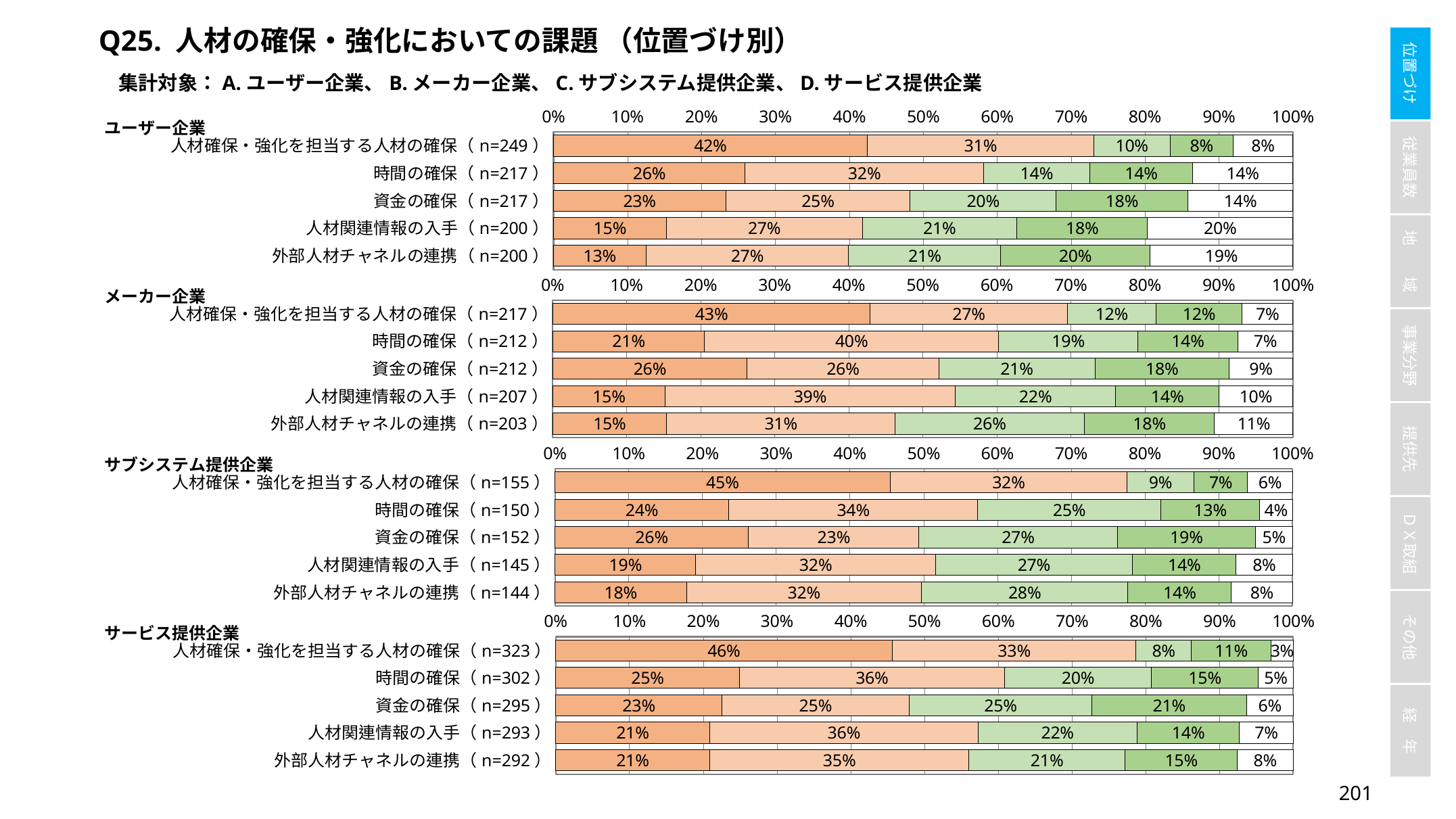
How many categories (bars) are shown in the ユーザー企業 chart? 5 In the ユーザー企業 chart, which category has the smallest leftmost (dark orange) segment? 外部人材チャネルの連携 In the サブシステム提供企業 chart, what is the value of the third (light green) segment for 外部人材チャネルの連携? 28% In the ユーザー企業 chart, what is the value of the leftmost (dark orange) segment for 人材確保・強化を担当する人材の確保? 42% In the サービス提供企業 chart, which category has the largest leftmost (dark orange) segment? 人材確保・強化を担当する人材の確保 What type of chart is used on this slide? Stacked bar chart In the サブシステム提供企業 chart, what is the difference between the leftmost segment values for 人材確保・強化を担当する人材の確保 and 時間の確保? 21 percentage points In the メーカー企業 chart, which has the larger leftmost (dark orange) segment: 資金の確保 or 人材関連情報の入手? 資金の確保 How many separate charts are shown on the slide? 4 In the サービス提供企業 chart, what is the sample size (n) shown for 時間の確保? n=302 In the サービス提供企業 chart, what is the value of the rightmost (white) segment for 人材確保・強化を担当する人材の確保? 3% In the メーカー企業 chart, what is the value of the second (light orange) segment for 時間の確保? 40%